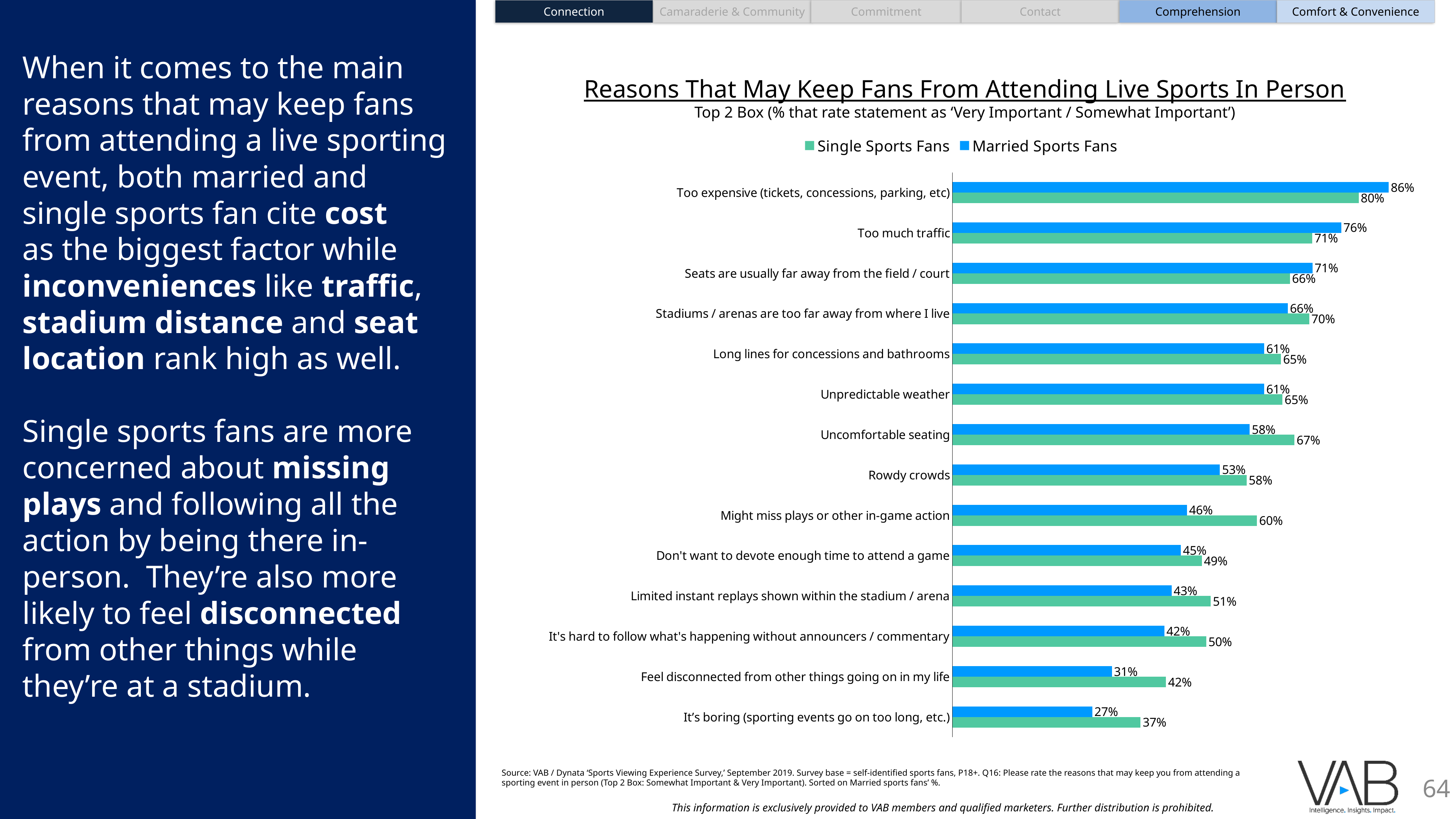
Which reason has the highest value for Married Sports Fans? Too expensive (tickets, concessions, parking, etc) For 'Too much traffic', which group has the higher value, Single Sports Fans or Married Sports Fans? Married Sports Fans What is the title of the chart? Reasons That May Keep Fans From Attending Live Sports In Person What percentage of Single Sports Fans rate 'Might miss plays or other in-game action' as important? 60% What is the difference between Single Sports Fans and Married Sports Fans for 'Might miss plays or other in-game action'? 14% Which reason has the lowest value for Single Sports Fans? It's boring (sporting events go on too long, etc.) For 'Feel disconnected from other things going on in my life', which group has the higher value? Single Sports Fans What is the value for Single Sports Fans for 'Uncomfortable seating'? 67% What type of chart is shown on the slide? Bar chart How many series does the legend list? 2 How many reasons (categories) are shown in the chart? 14 What percentage of Married Sports Fans rate 'Too expensive (tickets, concessions, parking, etc)' as important? 86%